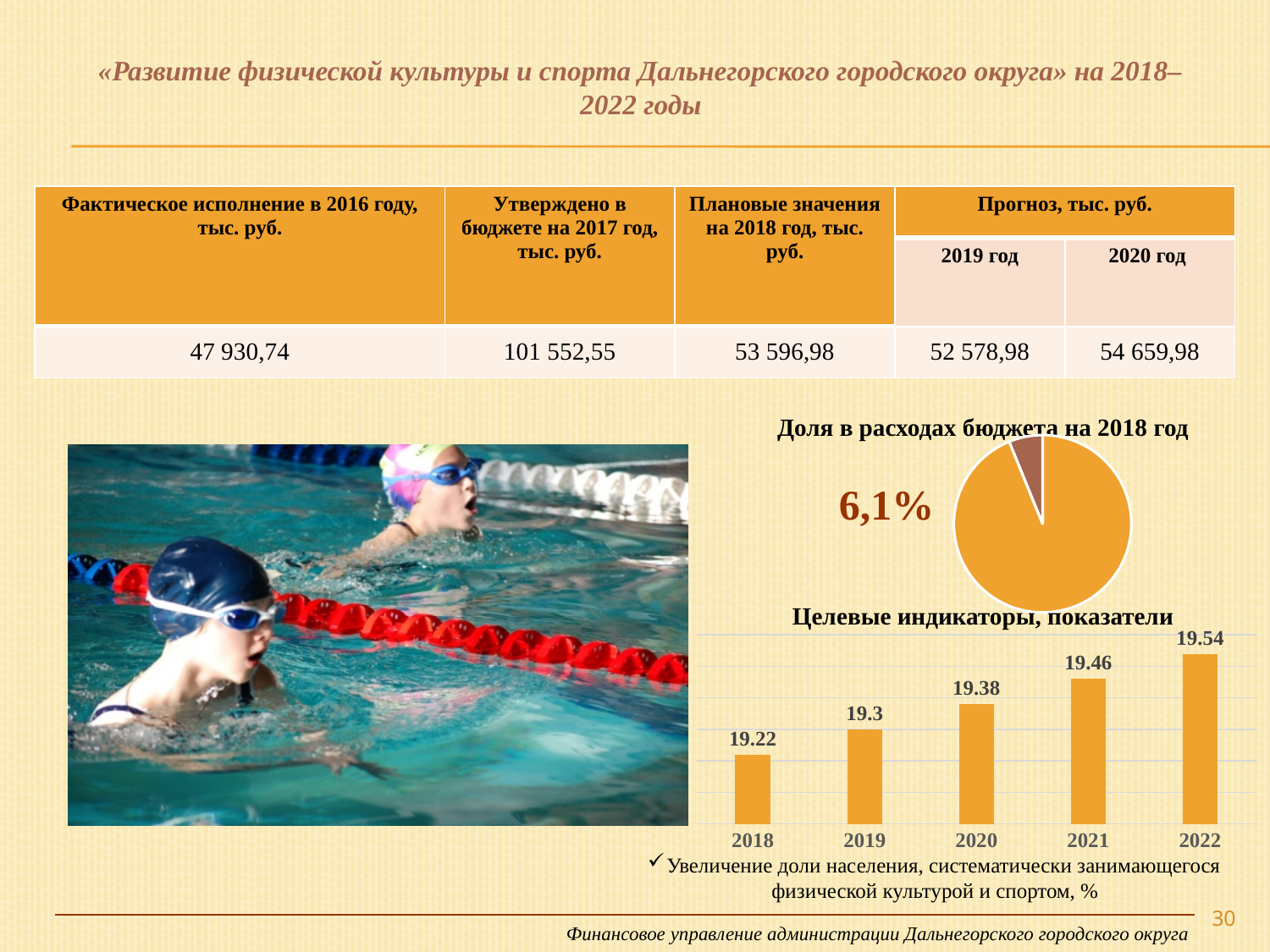
What kind of chart is 'Доля в расходах бюджета на 2018 год'? pie chart On the bar chart 'Целевые индикаторы, показатели', which year has the highest value? 2022 On the bar chart 'Целевые индикаторы, показатели', which is larger, the value for 2019 or the value for 2021? 2021 On the bar chart 'Целевые индикаторы, показатели', do the values rise or fall from 2018 to 2022? rise What kind of chart is 'Целевые индикаторы, показатели'? bar chart On the bar chart 'Целевые индикаторы, показатели', what is the value for 2022? 19.54 On the pie chart 'Доля в расходах бюджета на 2018 год', what share is shown for the highlighted slice? 6,1% On the bar chart 'Целевые индикаторы, показатели', which year has the lowest value? 2018 On the bar chart 'Целевые индикаторы, показатели', what is the difference between the values for 2022 and 2018? 0.32 On the bar chart 'Целевые индикаторы, показатели', what is the value for 2020? 19.38 How many years are shown on the bar chart 'Целевые индикаторы, показатели'? 5 On the bar chart 'Целевые индикаторы, показатели', what is the value for 2018? 19.22